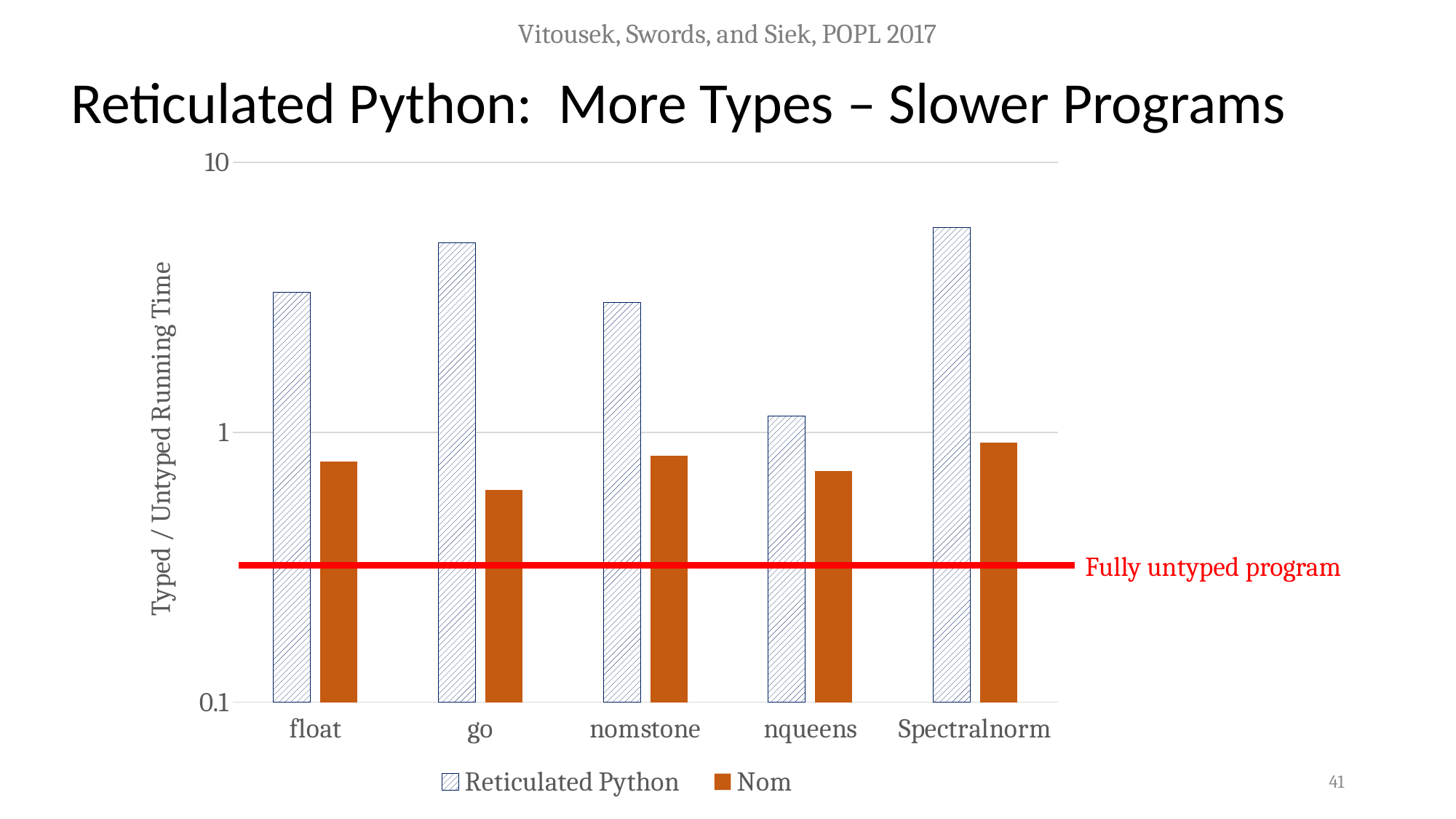
What kind of chart is shown on the slide? bar chart Which category has the lowest Nom value? go Is the Reticulated Python value for go greater or less than 10? less How many benchmark categories are shown on the x axis? 5 How many series does the legend list? 2 Is the Reticulated Python value for float greater or less than 1? greater Which category has the lowest Reticulated Python value? nqueens What is the label on the y axis? Typed / Untyped Running Time For go, which series has the larger value, Reticulated Python or Nom? Reticulated Python Which category has the highest Reticulated Python value? Spectralnorm Is the Nom value for float greater or less than 1? less Which category has the highest Nom value? Spectralnorm